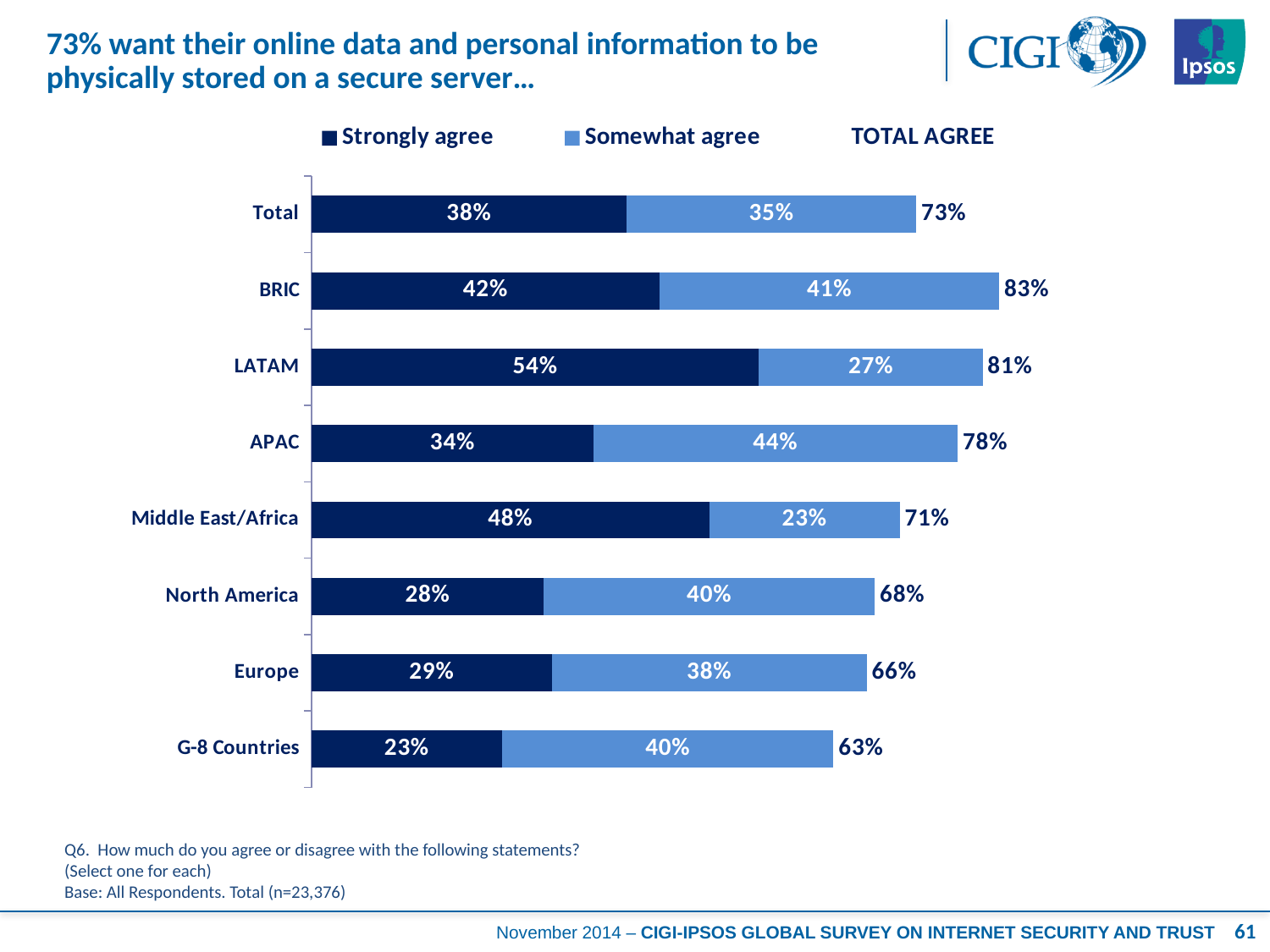
What is the difference between the Somewhat agree values for APAC and Middle East/Africa? 21% What is the Somewhat agree value for North America? 40% Which category has the lowest TOTAL AGREE value? G-8 Countries What is the total of the stacked bar for Middle East/Africa? 71% Which series is shown in dark blue? Strongly agree What kind of chart is shown on the slide? Stacked bar chart Which region has the highest Strongly agree value? LATAM What is the TOTAL AGREE value for BRIC? 83% What is the Strongly agree value for LATAM? 54% How many categories are shown on the chart? 8 Which is larger, the Strongly agree value for Europe or for G-8 Countries? Europe How many series does the legend list? 3